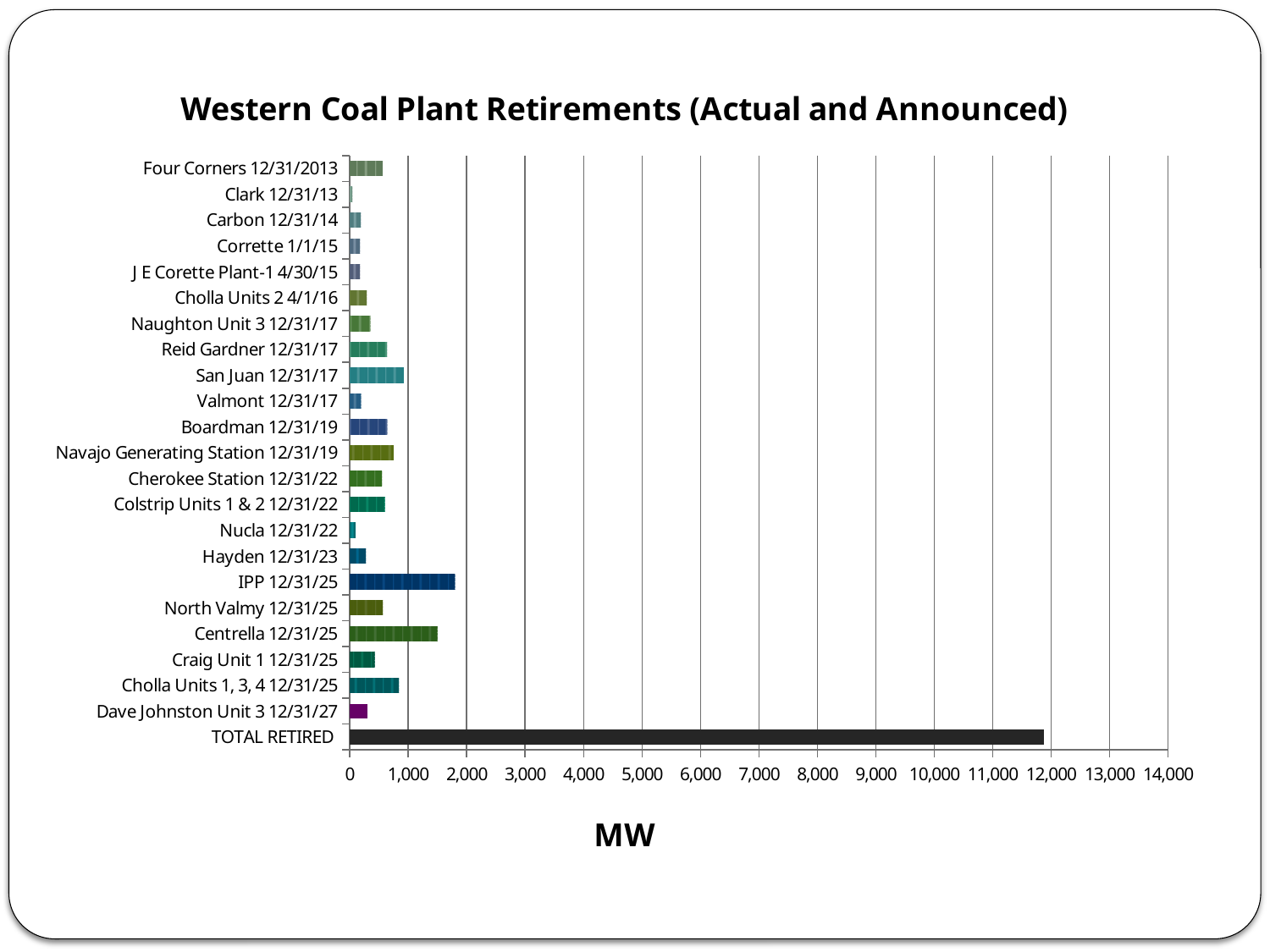
Is the value for IPP 12/31/25 greater or less than 1,000 MW? greater Which plant has the smallest retirement in MW? Clark 12/31/13 Is the value for Centrella 12/31/25 greater or less than 1,000 MW? greater What kind of chart is shown on the slide? bar chart Which category has the longest bar in the chart? TOTAL RETIRED How many bars (categories) are plotted in the chart, including TOTAL RETIRED? 23 What is the title of the chart? Western Coal Plant Retirements (Actual and Announced) Excluding TOTAL RETIRED, which plant has the largest retirement in MW? IPP 12/31/25 What unit is shown on the horizontal axis label? MW Which is larger, the value for IPP 12/31/25 or the value for Centrella 12/31/25? IPP 12/31/25 Is the value for TOTAL RETIRED greater or less than 11,000 MW? greater